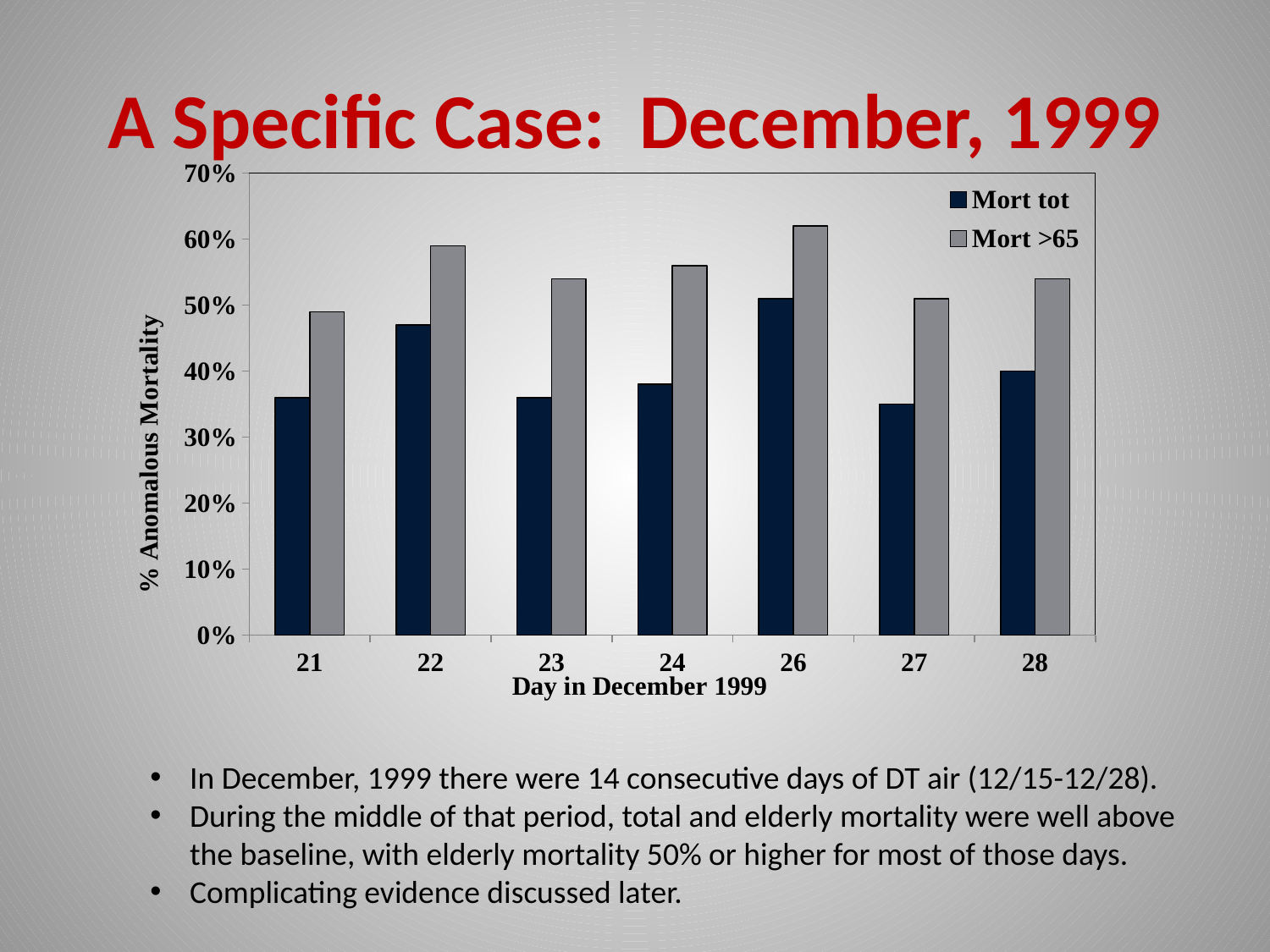
How many series does the legend list? 2 How many days are shown on the x axis of the chart? 7 Is the Mort >65 value for day 26 greater or less than 60%? greater What is the label of the y axis of the chart? % Anomalous Mortality On which day is the Mort tot value highest? 26 Is the Mort tot value for day 22 greater or less than 40%? greater Is the Mort tot value for day 21 greater or less than 40%? less What is the label of the x axis of the chart? Day in December 1999 What kind of chart is shown on the slide? bar chart On which day is the Mort >65 value highest? 26 On day 21, which is larger, Mort tot or Mort >65? Mort >65